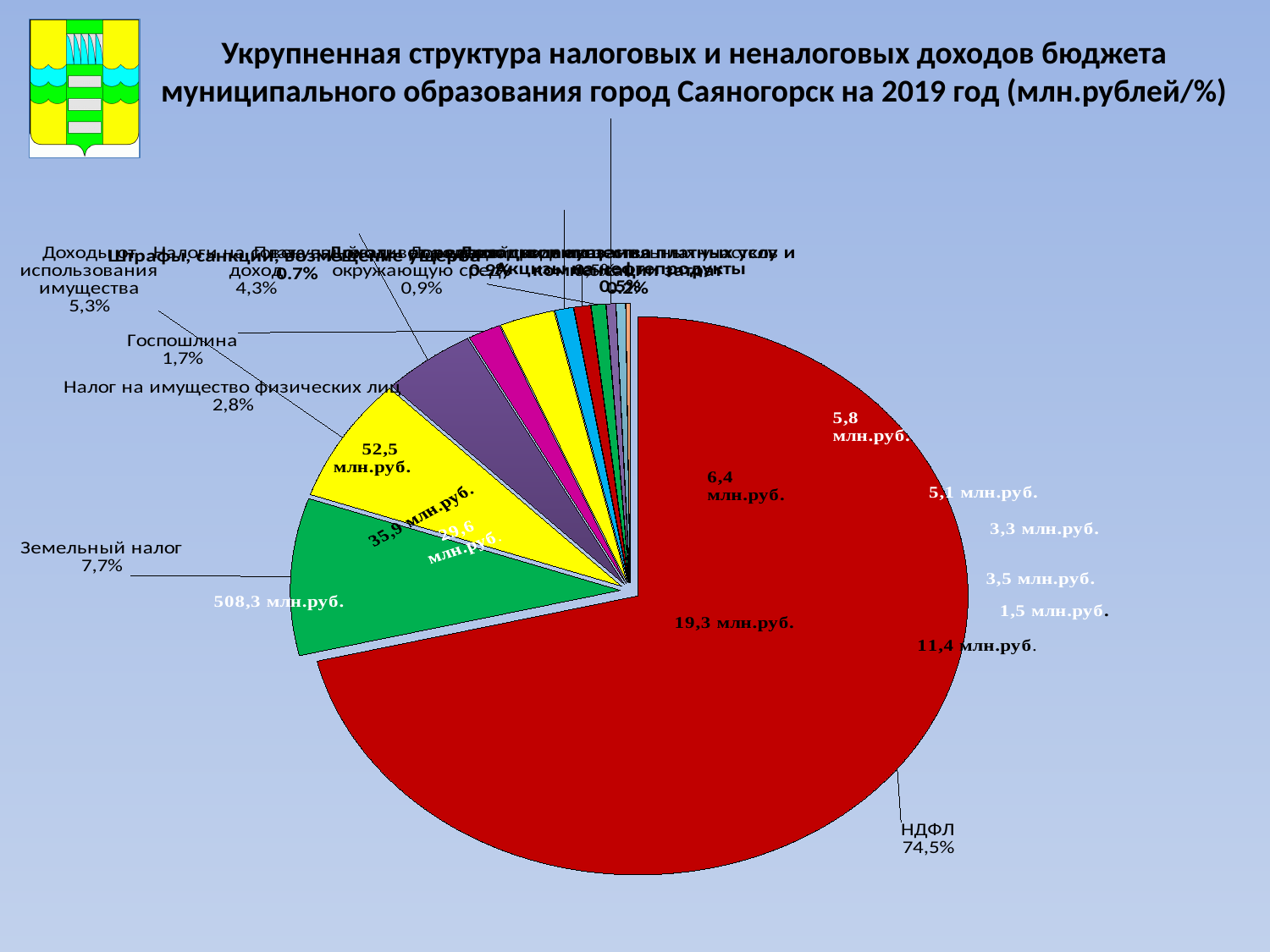
Which is larger: the share of Налог на имущество физических лиц or the share of Доходы от использования имущества? Доходы от использования имущества What share of the pie does Доходы от использования имущества account for? 5,3% What kind of chart is shown on the slide? pie chart For which year does the chart title say the budget revenue structure is shown? 2019 What share of the pie does Госпошлина account for? 1,7% What is the largest value label printed on the chart? 508,3 млн.руб. What share of the pie does Земельный налог account for? 7,7% Which category has the largest slice of the pie? НДФЛ What is the difference in percentage points between the share of НДФЛ and the share of Земельный налог? 66,8% Which is larger: the share of Земельный налог or the share of Госпошлина? Земельный налог